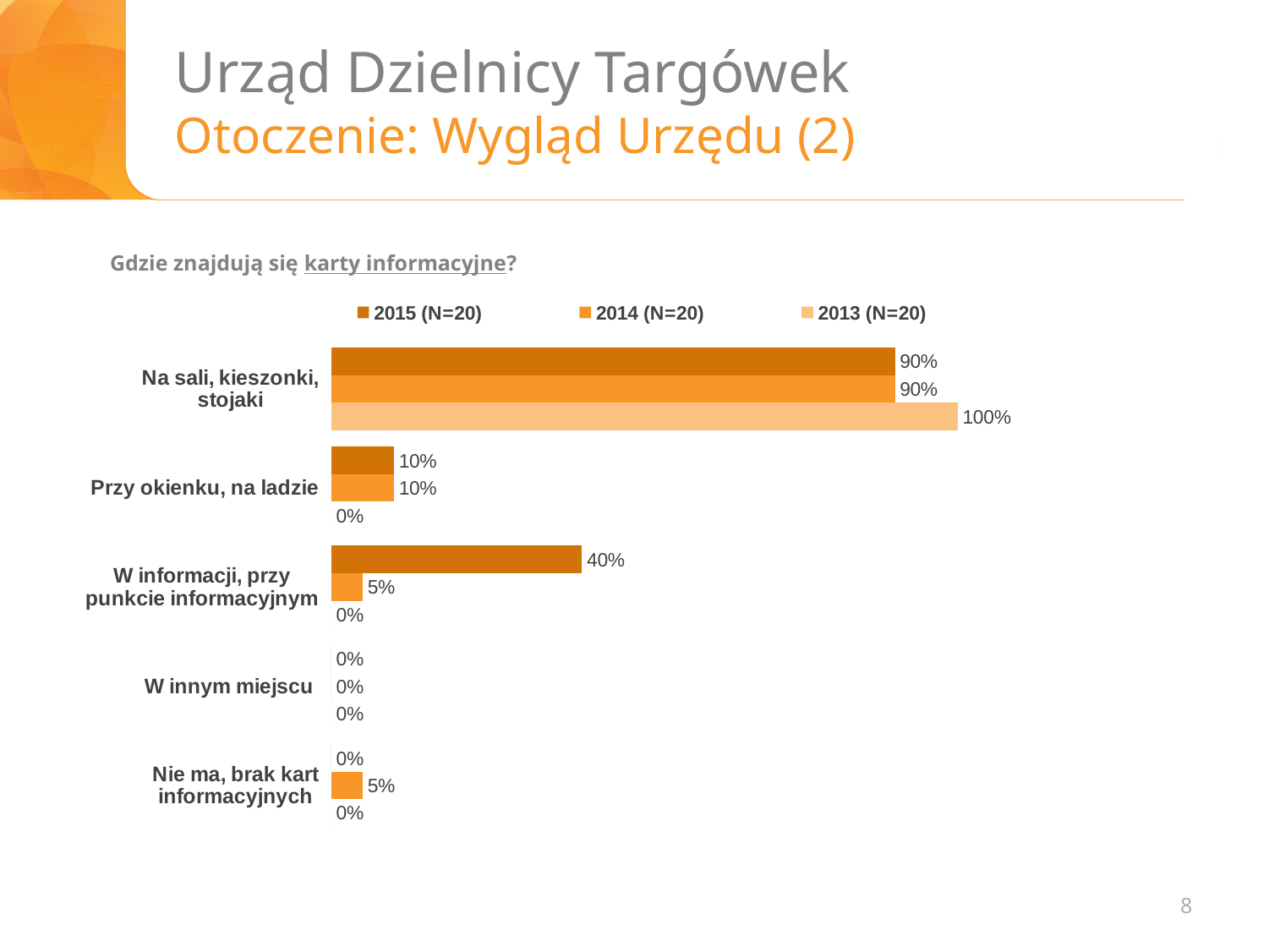
What kind of chart is shown on the slide? Bar chart What is the difference between the 2013 (N=20) and 2015 (N=20) values for "Na sali, kieszonki, stojaki"? 10% What question does the chart answer, according to the text above it? Gdzie znajdują się karty informacyjne? What is the value for "Nie ma, brak kart informacyjnych" in the 2014 (N=20) series? 5% What is the value for "Przy okienku, na ladzie" in the 2013 (N=20) series? 0% Which category has the highest value in the 2015 (N=20) series? Na sali, kieszonki, stojaki How many categories are shown on the chart? 5 What is the difference between the 2015 (N=20) and 2014 (N=20) values for "W informacji, przy punkcie informacyjnym"? 35% What is the value for "W informacji, przy punkcie informacyjnym" in the 2015 (N=20) series? 40% How many series does the legend list? 3 For "Przy okienku, na ladzie", which series has the larger value: 2015 (N=20) or 2013 (N=20)? 2015 (N=20) What is the value for "Na sali, kieszonki, stojaki" in the 2013 (N=20) series? 100%